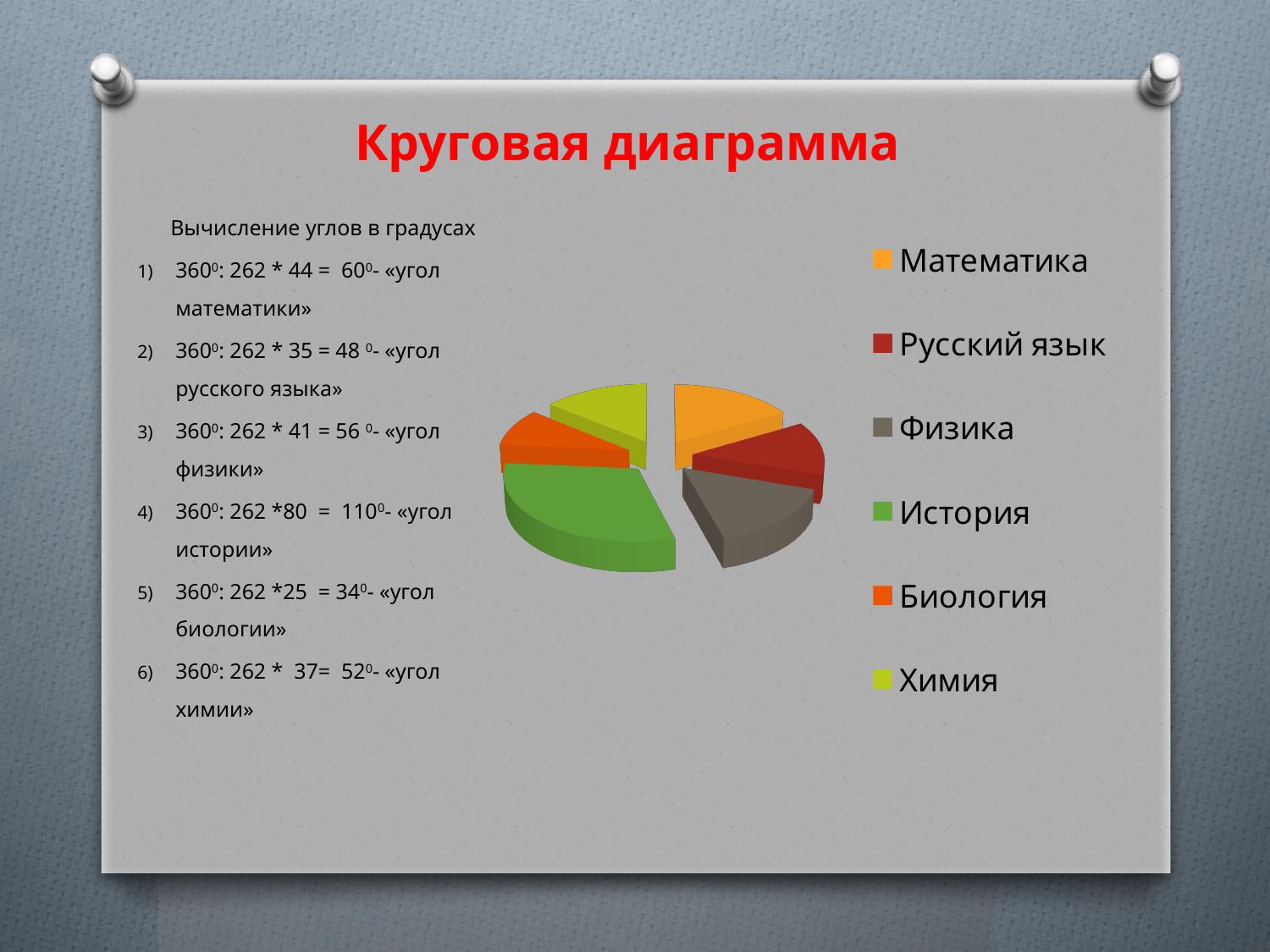
What is the title of the slide containing the pie chart? Круговая диаграмма How many slices does the pie chart have? 6 Which category has the smallest slice in the pie chart? Биология What colour is the История slice in the pie chart? green What kind of chart is shown on the slide? pie chart Which slice is larger in the pie chart, Физика or Биология? Физика Which slice is larger in the pie chart, История or Математика? История Which slice is larger in the pie chart, Математика or Биология? Математика How many entries does the legend of the pie chart list? 6 Which category has the largest slice in the pie chart? История